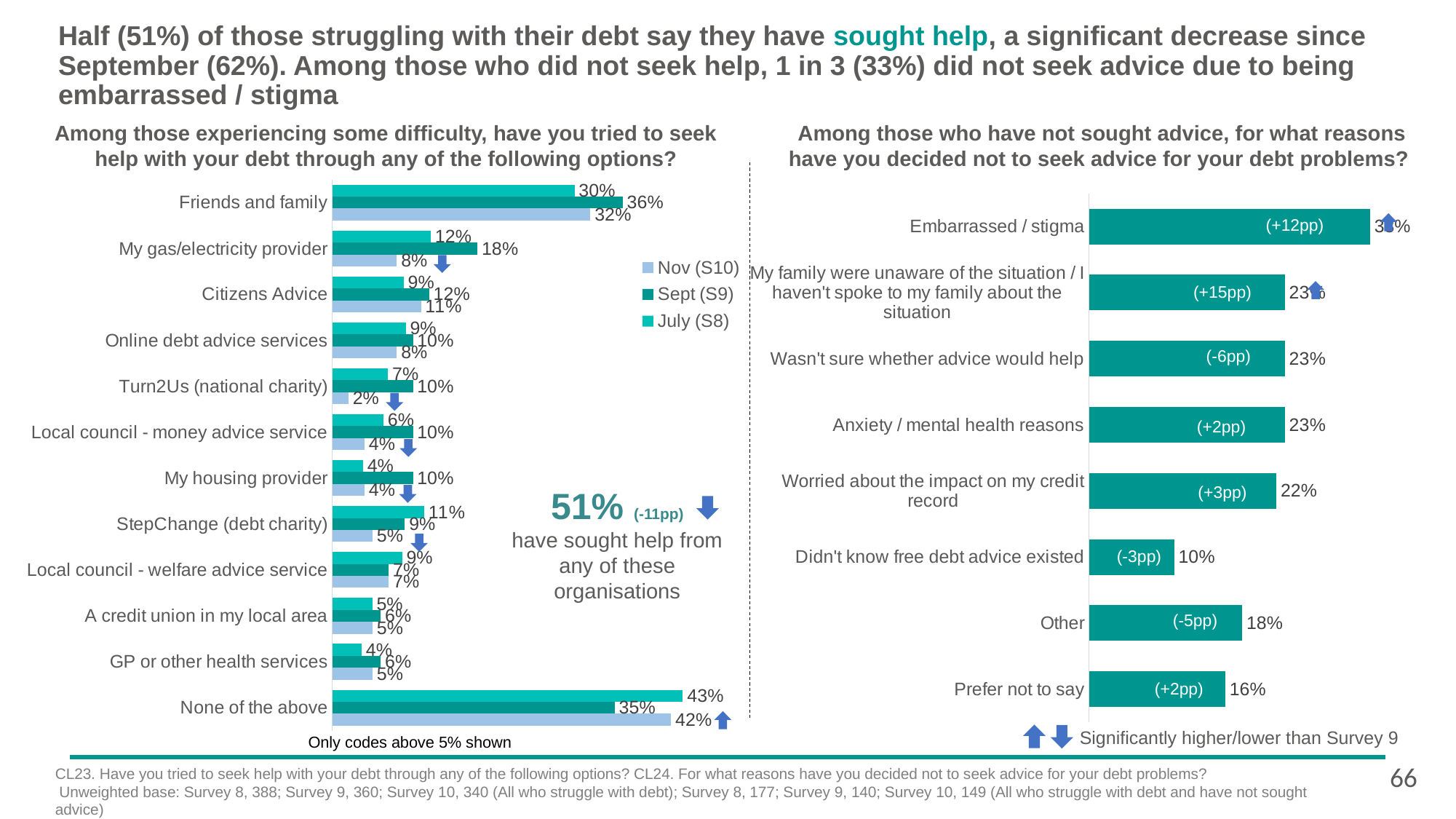
How many series does the legend of the left chart (have you tried to seek help) list? 3 In the left chart (have you tried to seek help), what is the July (S8) value for StepChange (debt charity)? 11% In the left chart (have you tried to seek help), what is the difference between the Sept (S9) and Nov (S10) values for My gas/electricity provider? 10% In the right chart (reasons for not seeking advice), which reason has the lowest value? Didn't know free debt advice existed How many reasons are shown in the right chart (reasons for not seeking advice)? 8 In the left chart (have you tried to seek help), what is the Sept (S9) value for Friends and family? 36% How many categories are shown in the left chart (have you tried to seek help)? 12 In the right chart (reasons for not seeking advice), which reason has the highest value? Embarrassed / stigma In the right chart (reasons for not seeking advice), what is the value for Other? 18% In the left chart (have you tried to seek help), what is the Nov (S10) value for Turn2Us (national charity)? 2% What kind of chart is the right chart (reasons for not seeking advice)? Bar chart In the left chart (have you tried to seek help), which is larger for None of the above: the Nov (S10) value or the Sept (S9) value? Nov (S10)